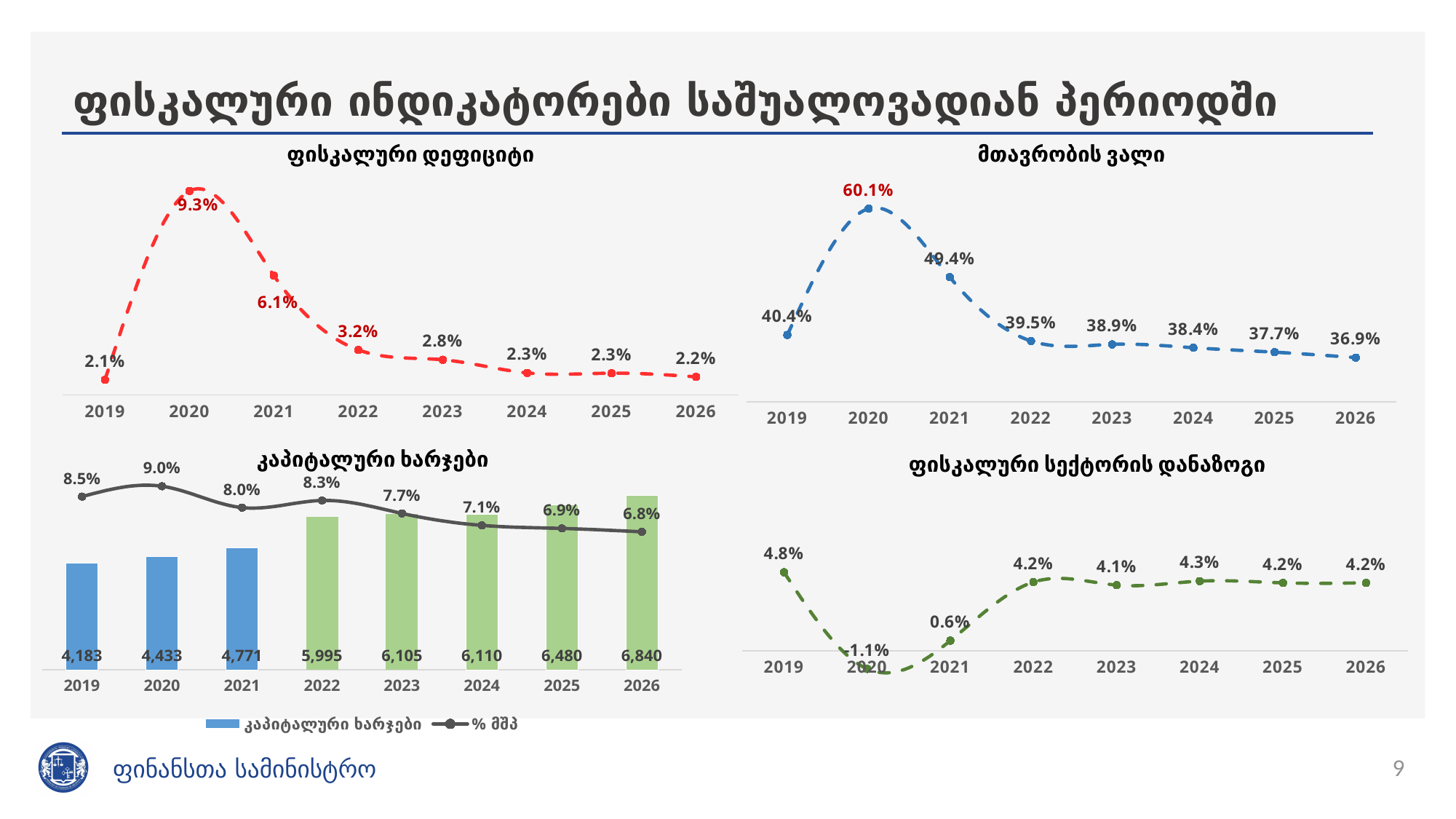
In the bottom-left chart (კაპიტალური ხარჯები), what is the % მშპ value for 2020? 9.0% In the bottom-left chart (კაპიტალური ხარჯები), how many series does the legend list? 2 How many years are shown on the x axis of the bottom-right chart (ფისკალური სექტორის დანაზოგი)? 8 In the top-left chart (ფისკალური დეფიციტი), what is the difference between the 2021 and 2022 values? 2.9% In the top-right chart (მთავრობის ვალი), do the values rise or fall from 2022 to 2026? fall In the top-left chart (ფისკალური დეფიციტი), what is the value for 2020? 9.3% In the top-left chart (ფისკალური დეფიციტი), which year has the lowest value? 2019 In the top-right chart (მთავრობის ვალი), what is the value for 2026? 36.9% In the bottom-left chart (კაპიტალური ხარჯები), which is larger, the bar for 2021 or the bar for 2022? 2022 In the bottom-left chart (კაპიტალური ხარჯები), what is the bar value for 2023? 6,105 In the top-right chart (მთავრობის ვალი), which year has the highest value? 2020 In the bottom-right chart (ფისკალური სექტორის დანაზოგი), what is the value for 2024? 4.3%